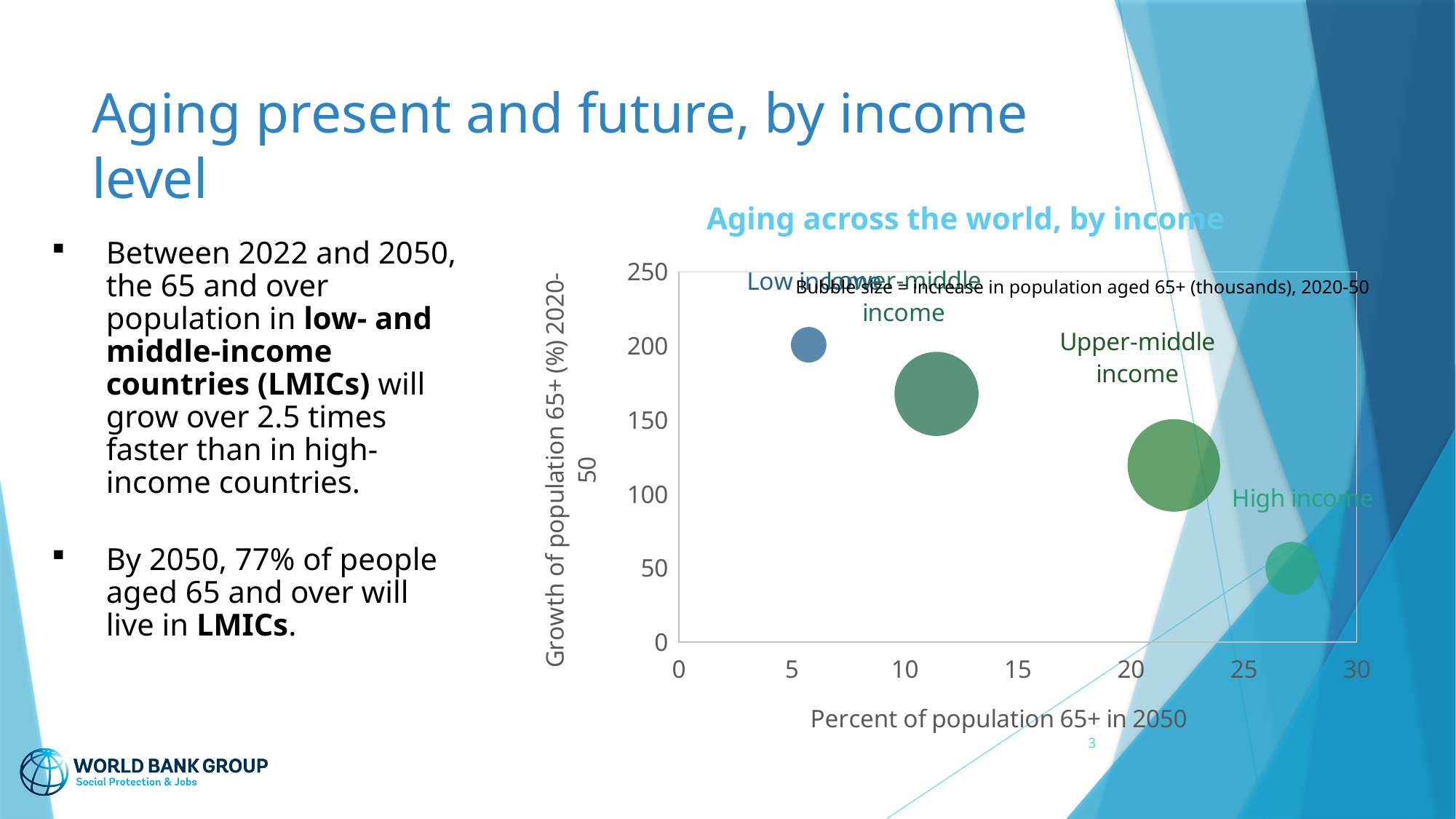
As the percent of population 65+ in 2050 increases along the x axis, does the growth of population 65+ rise or fall? fall Is the growth of population 65+ for Upper-middle income greater or less than 100? greater Which income group has the highest growth of population 65+ (%) 2020-50? Low income Is the growth of population 65+ for High income greater or less than 100? less What kind of chart is shown on the slide? bubble chart What does the bubble size represent in the chart? Increase in population aged 65+ (thousands), 2020-50 Which income group has the largest bubble (largest increase in population aged 65+)? Upper-middle income How many income groups are plotted in the chart? 4 Which income group has the lowest growth of population 65+ (%) 2020-50? High income Is the growth of population 65+ for Low income greater or less than 150? greater Which has a higher growth of population 65+: Lower-middle income or Upper-middle income? Lower-middle income